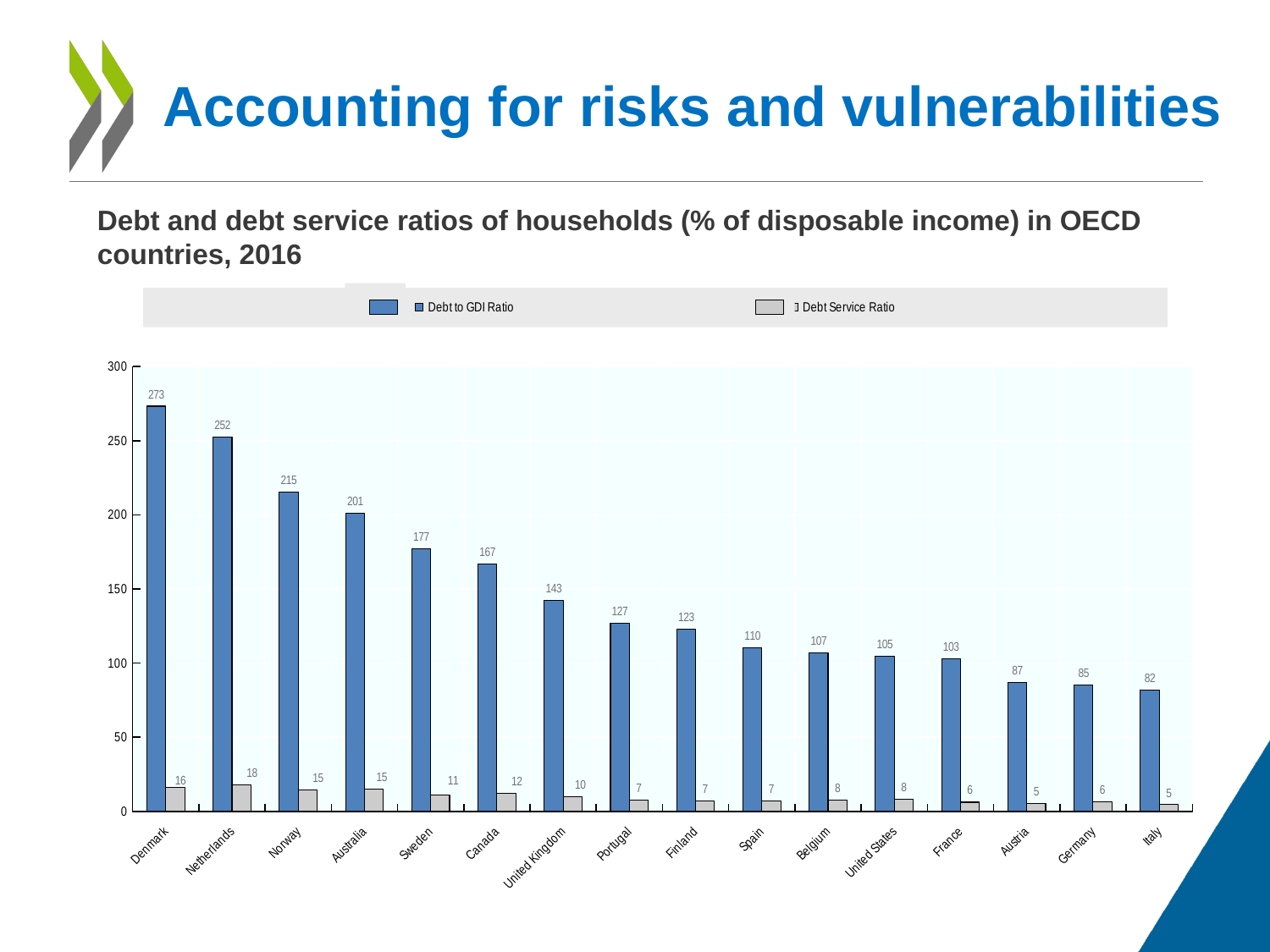
What is the Debt to GDI Ratio for Denmark? 273 What is the Debt Service Ratio for the Netherlands? 18 Which has a higher Debt to GDI Ratio, Sweden or Canada? Sweden Which country has the highest Debt Service Ratio? Netherlands Do the Debt to GDI Ratio values rise or fall from left to right across the countries? Fall How many countries are shown on the chart? 16 What is the difference between the Debt to GDI Ratio of Norway and Australia? 14 How many series does the legend list? 2 Which country has the lowest Debt to GDI Ratio? Italy What kind of chart is shown on the slide? Bar chart What is the Debt to GDI Ratio for the United Kingdom? 143 Which country has the highest Debt to GDI Ratio? Denmark